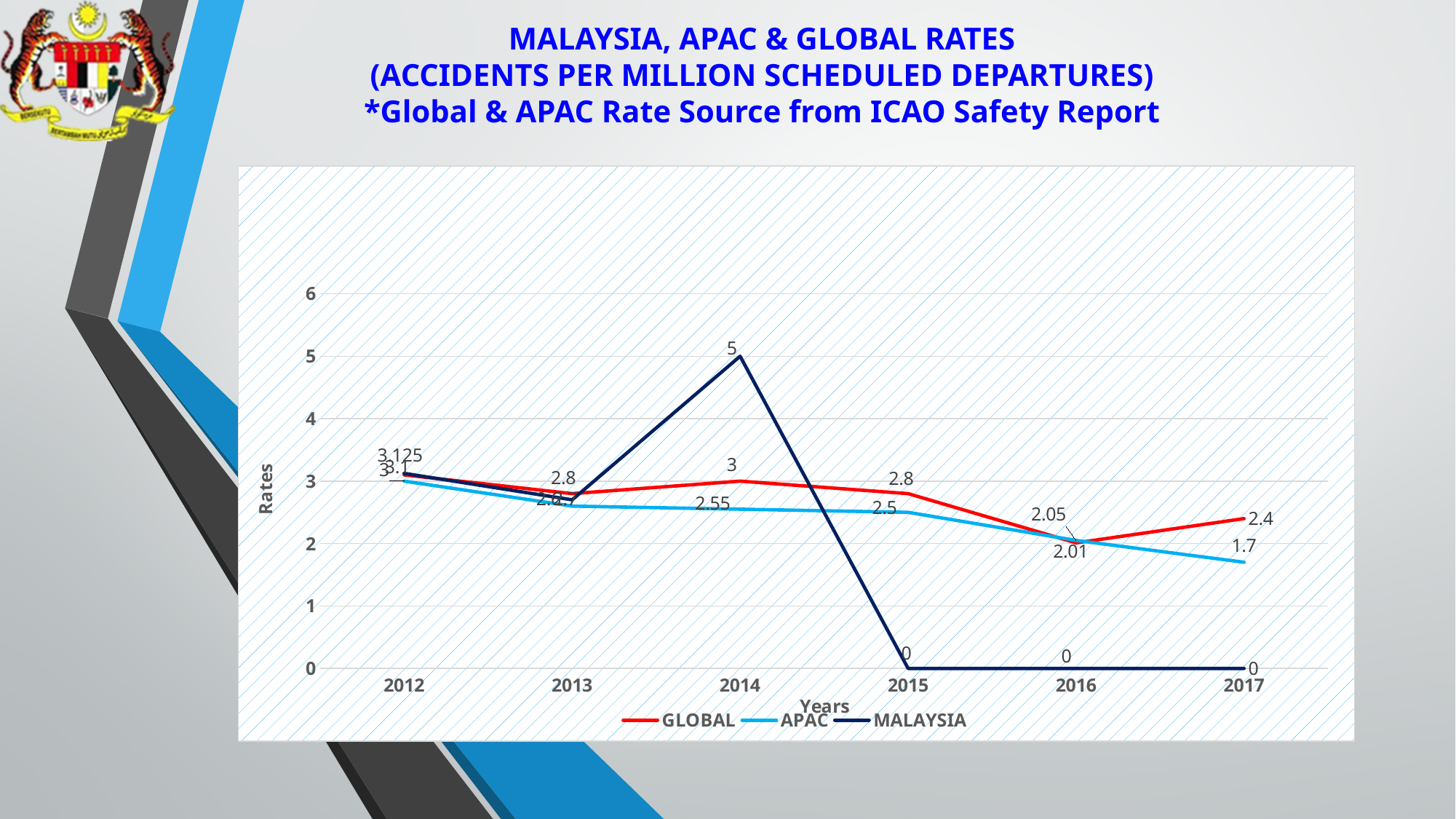
What is the GLOBAL rate in 2017? 2.4 What is the difference between the GLOBAL and APAC rates in 2017? 0.7 How many series does the legend list? 3 What is the MALAYSIA rate in 2014? 5 What is the APAC rate in 2014? 2.55 What is the MALAYSIA rate in 2012? 3.125 In 2014, which series has the higher rate, MALAYSIA or GLOBAL? MALAYSIA Does the APAC series rise or fall from 2012 to 2017? Fall What is the APAC rate in 2017? 1.7 What kind of chart is shown on the slide? Line chart In which year does the MALAYSIA series reach its highest value? 2014 What is the GLOBAL rate in 2014? 3